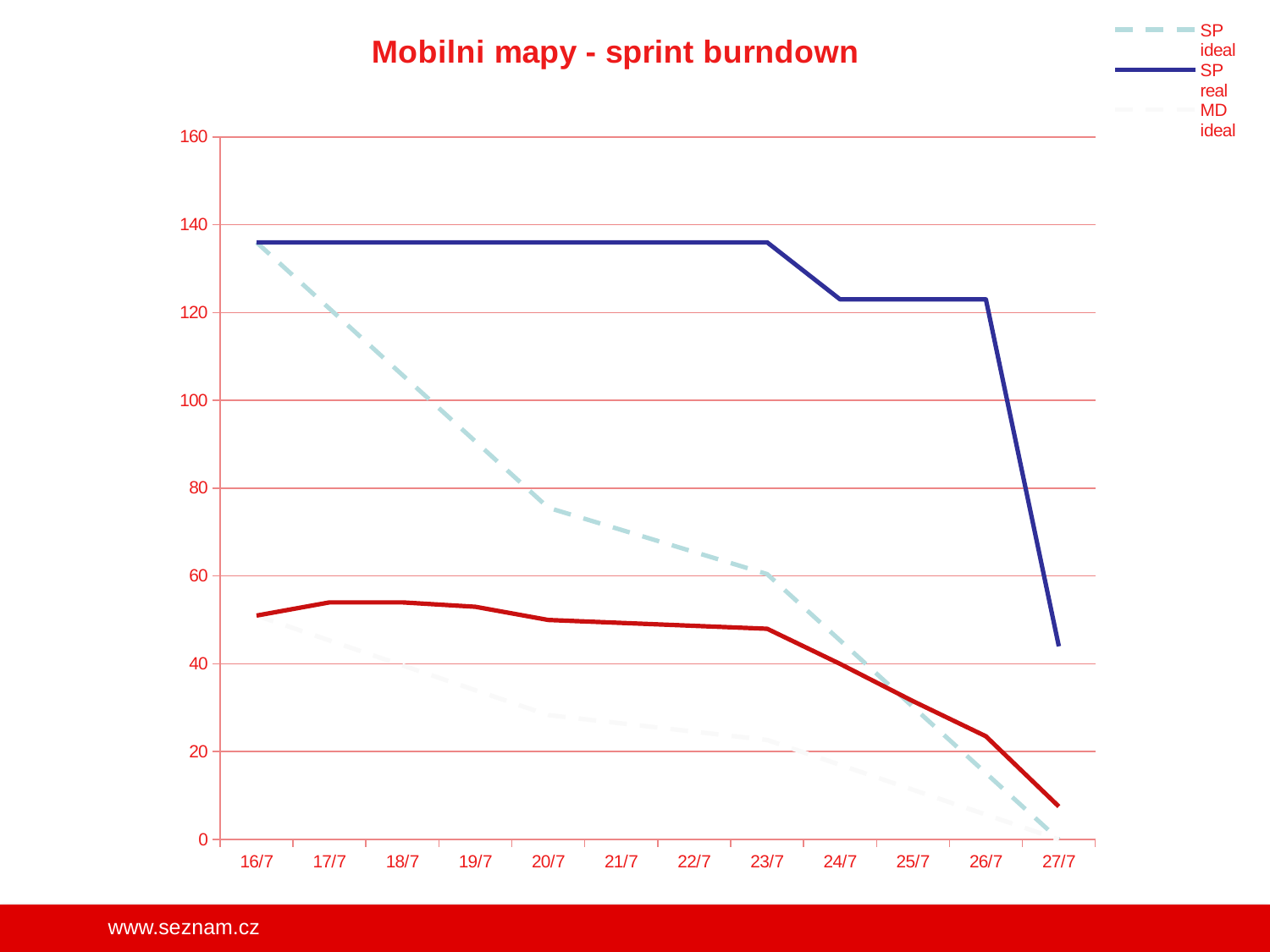
On which date is SP real at its lowest? 27/7 Does the SP ideal line rise or fall from 16/7 to 27/7? fall How many dates are shown on the x axis of the chart? 12 Which series is drawn as a light blue dashed line? SP ideal Is the value of SP real on 16/7 greater or less than 120? greater Is the value of SP real on 24/7 greater or less than 100? greater What kind of chart is shown on the slide? line chart On 27/7, which is larger: SP real or SP ideal? SP real Is the value of SP real on 27/7 greater or less than 60? less What is the title of the chart? Mobilni mapy - sprint burndown